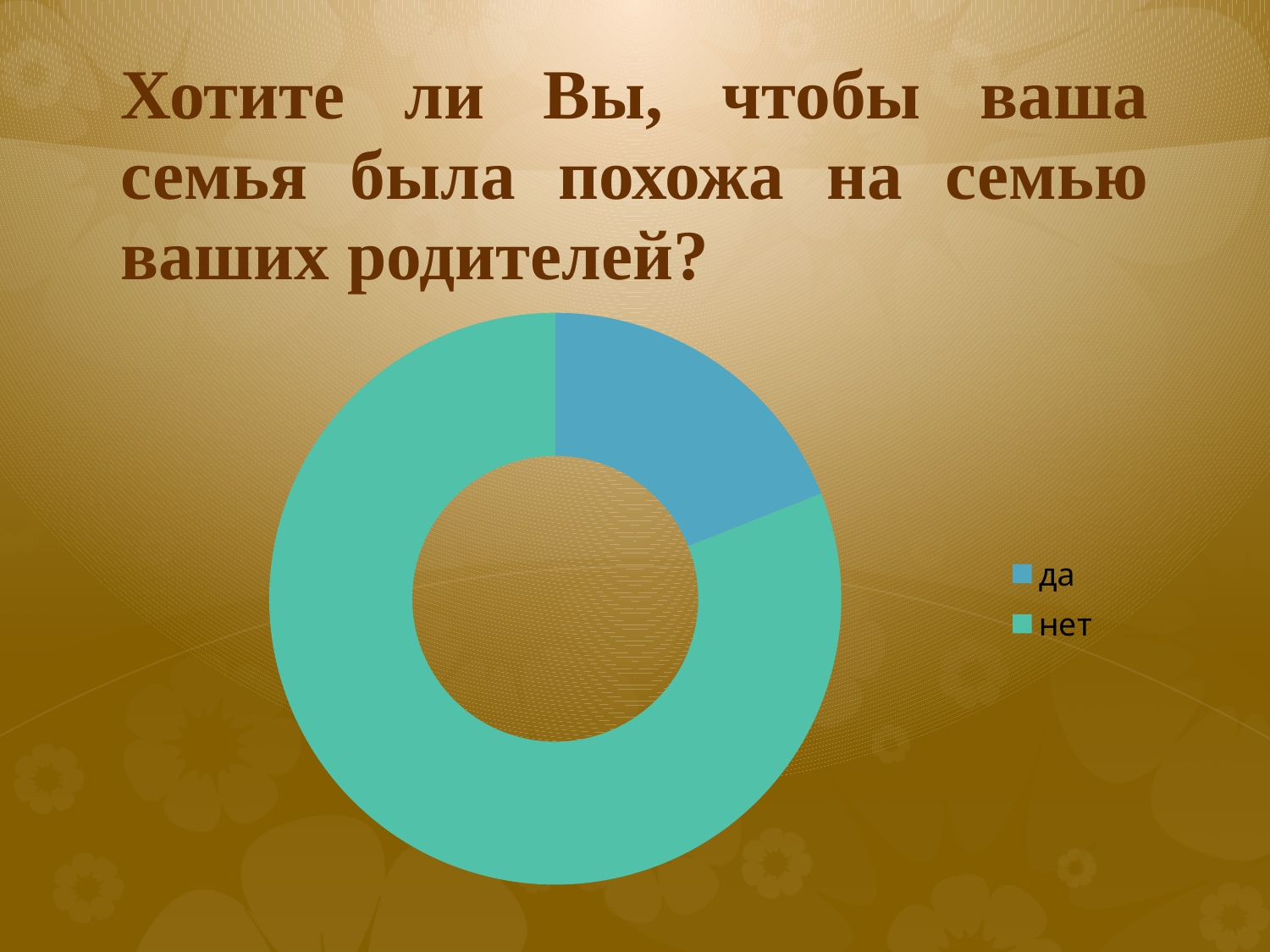
How many entries does the legend list? 2 What colour represents the category нет in the chart? teal Which category has the smallest share of the chart? да How many categories does the chart show? 2 What colour represents the category да in the chart? blue Which category has the largest share of the chart? нет Which is larger, the share for да or the share for нет? нет What kind of chart is shown on the slide? doughnut chart